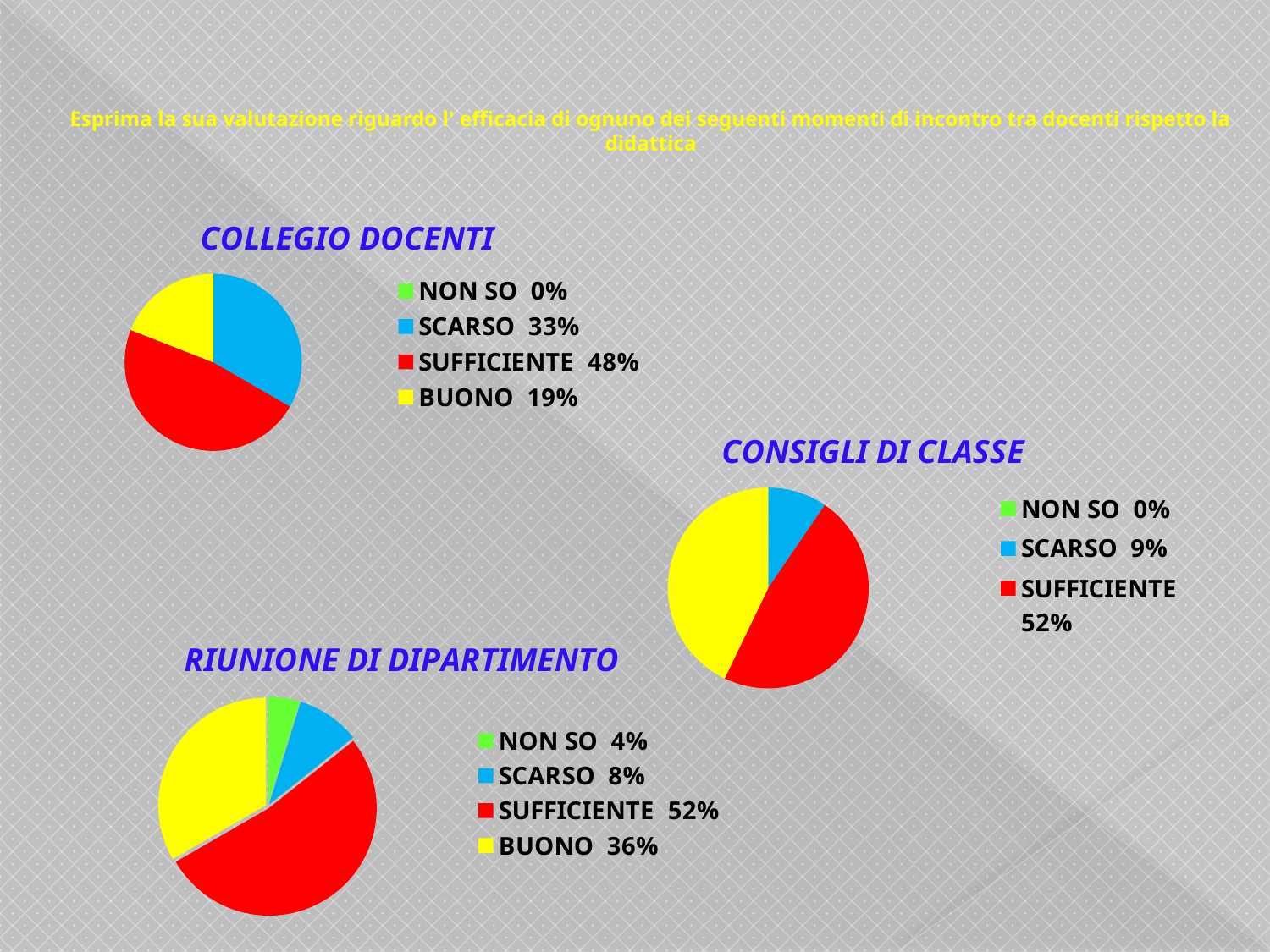
In the CONSIGLI DI CLASSE chart, what percentage is SUFFICIENTE? 52% What type of chart is the COLLEGIO DOCENTI chart? Pie chart In the RIUNIONE DI DIPARTIMENTO chart, what is the difference between SUFFICIENTE and BUONO? 16% How many categories does the legend of the RIUNIONE DI DIPARTIMENTO chart list? 4 In the RIUNIONE DI DIPARTIMENTO chart, what percentage is NON SO? 4% In the CONSIGLI DI CLASSE chart, what percentage is SCARSO? 9% In the COLLEGIO DOCENTI chart, what is the difference between SUFFICIENTE and BUONO? 29% In the RIUNIONE DI DIPARTIMENTO chart, what percentage is BUONO? 36% In the COLLEGIO DOCENTI chart, which category has the largest share? SUFFICIENTE In the CONSIGLI DI CLASSE chart, which is larger, SCARSO or SUFFICIENTE? SUFFICIENTE In the COLLEGIO DOCENTI chart, what percentage is SUFFICIENTE? 48% In the COLLEGIO DOCENTI chart, what percentage is SCARSO? 33%